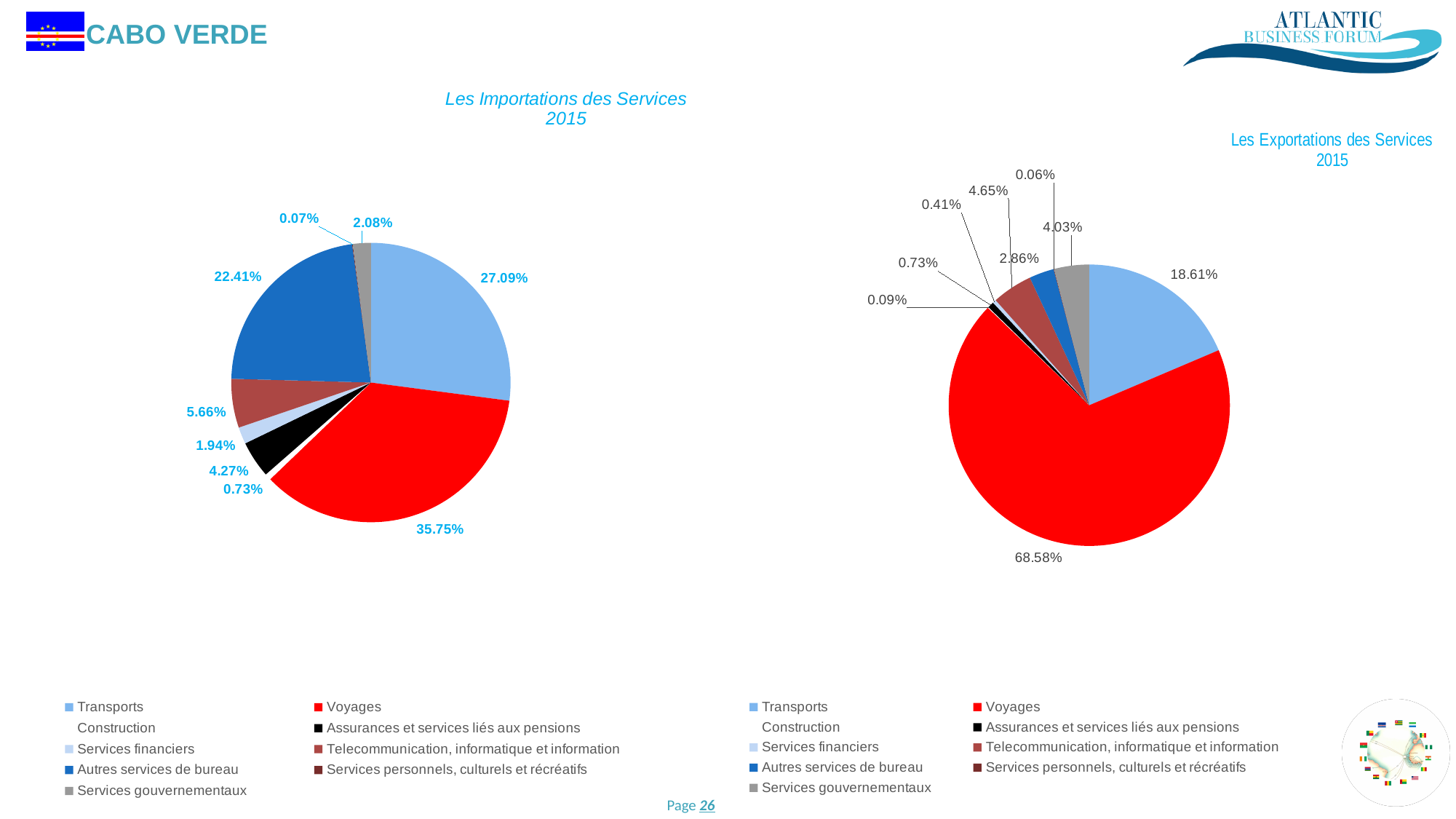
In the 'Les Importations des Services 2015' chart, what share does Voyages have? 35.75% In the 'Les Importations des Services 2015' chart, what is the value for Autres services de bureau? 22.41% How many entries does the legend of the 'Les Importations des Services 2015' chart list? 9 What type of chart is 'Les Exportations des Services 2015'? Pie chart In the 'Les Importations des Services 2015' chart, which category has the largest slice? Voyages In the 'Les Exportations des Services 2015' chart, what share does Voyages have? 68.58% In the 'Les Exportations des Services 2015' chart, what is the value for Transports? 18.61% In the 'Les Importations des Services 2015' chart, what is the difference between the Voyages and Transports shares? 8.66% In the 'Les Exportations des Services 2015' chart, which is larger: Autres services de bureau or Services gouvernementaux? Services gouvernementaux In the 'Les Exportations des Services 2015' chart, what colour is the Voyages slice? Red In the 'Les Importations des Services 2015' chart, what is the value for Telecommunication, informatique et information? 5.66% In the 'Les Exportations des Services 2015' chart, which category has the smallest slice? Services personnels, culturels et récréatifs